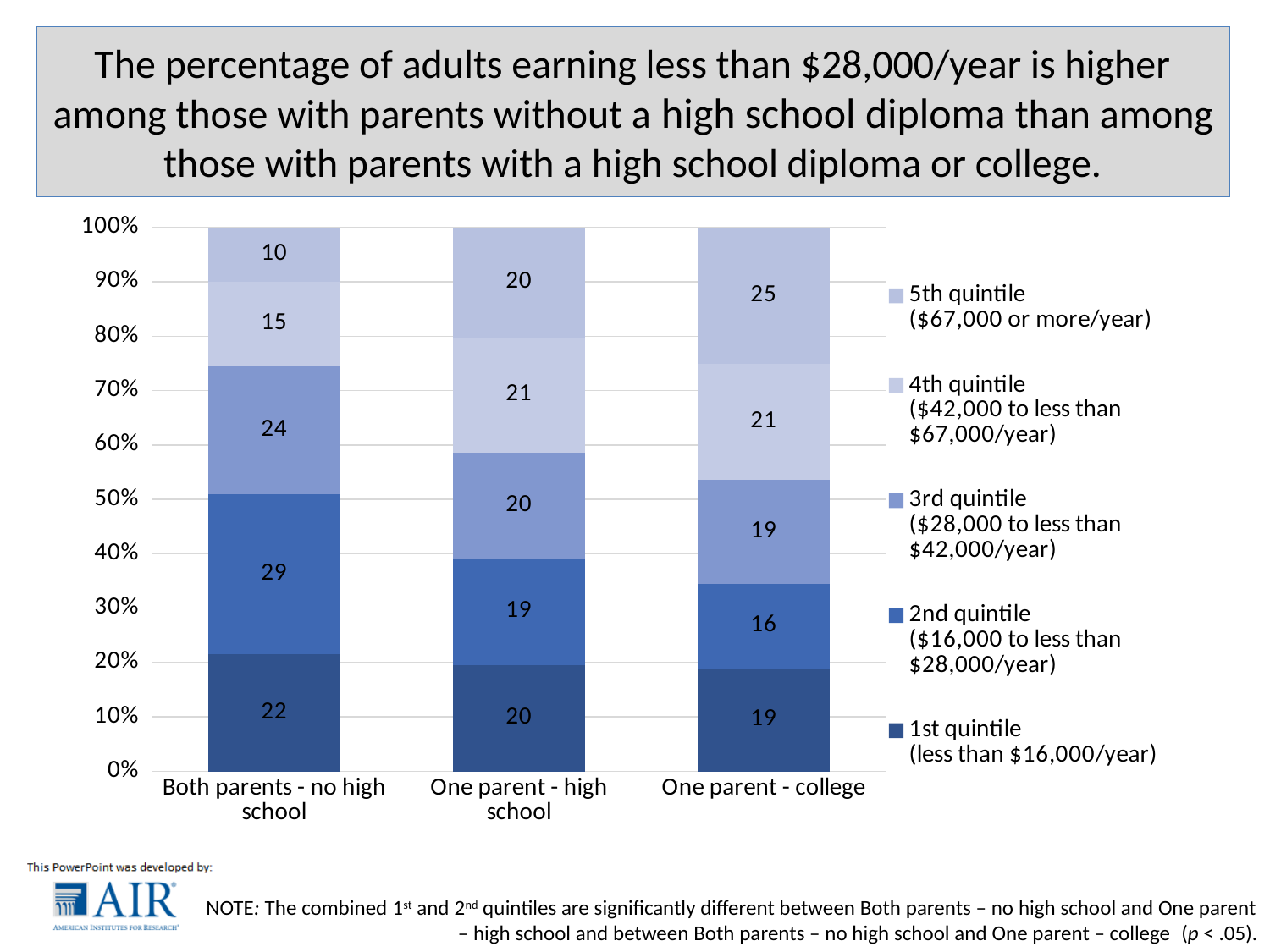
What is the combined value of the 1st and 2nd quintile segments for Both parents - no high school? 51 Which is larger: the 5th quintile value for Both parents - no high school or for One parent - high school? One parent - high school Which category has the highest 5th quintile value? One parent - college What kind of chart is shown on the slide? Stacked bar chart How many categories are shown on the x axis? 3 What is the difference between the 2nd quintile values for Both parents - no high school and One parent - college? 13 How many series does the legend list? 5 What is the value of the 1st quintile segment for One parent - college? 19 What is the value of the 4th quintile segment for One parent - high school? 21 What is the value of the 2nd quintile segment for Both parents - no high school? 29 What is the value of the 5th quintile segment for One parent - college? 25 Which category has the lowest 2nd quintile value? One parent - college